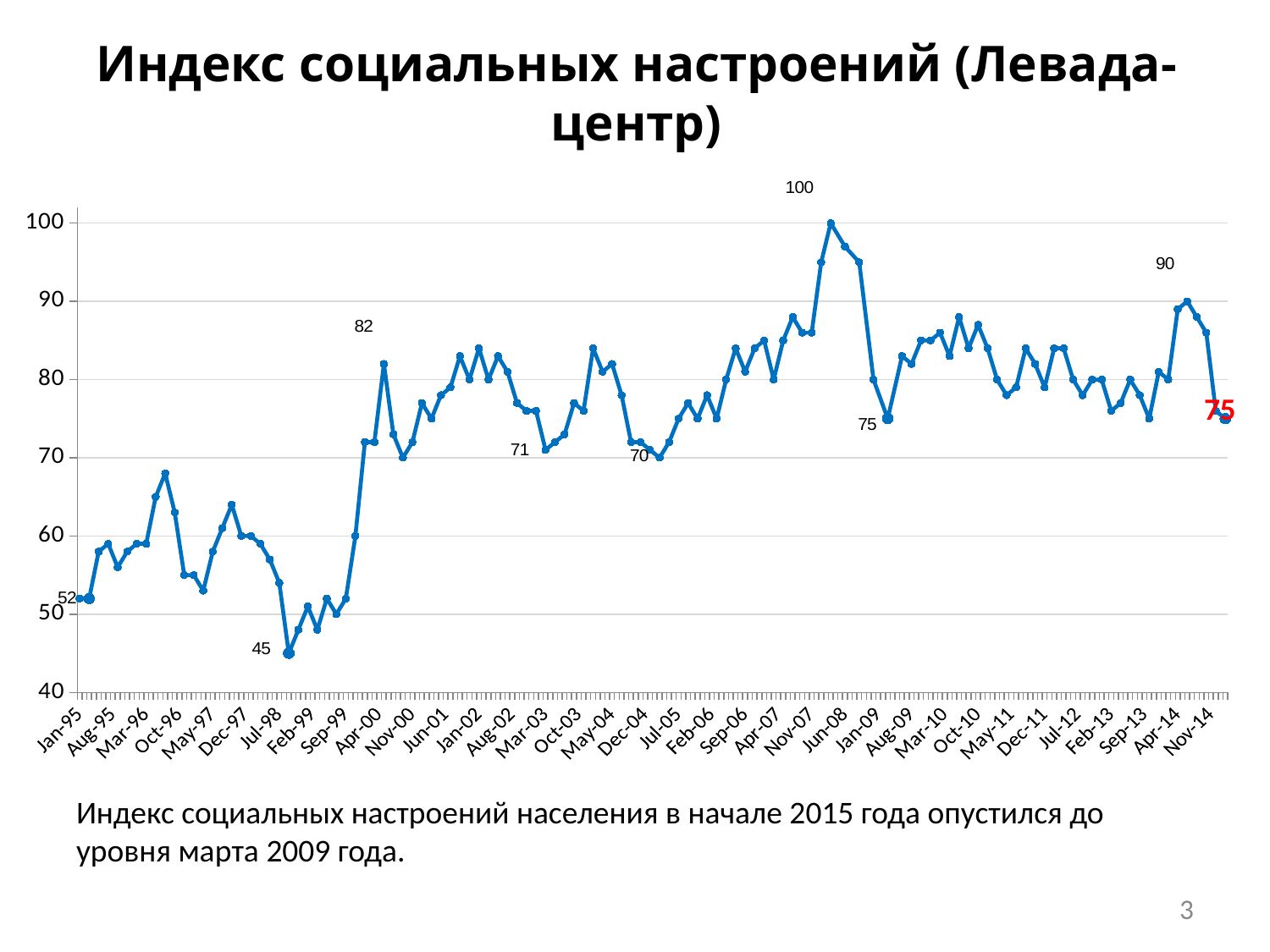
By how much did the index fall from its peak of 100 near Jun-08 to the labelled value of 75 in early 2009? 25 What kind of chart is shown on the slide? line chart What is the highest value labelled on the chart? 100 What value is labelled at the peak near Apr-14? 90 What is the value of the first point on the chart, at Jan-95? 52 What is the value of the last point on the chart, shown in red? 75 What is the lowest value labelled on the chart? 45 What is the difference between the highest labelled value (100) and the lowest labelled value (45)? 55 Which is larger: the labelled value near Mar-03 or the labelled value near Dec-04? Mar-03 (71) What is the title of the chart? Индекс социальных настроений (Левада-центр) What value is labelled at the peak near Apr-00? 82 Is the value at Jan-95 greater or less than 60? less